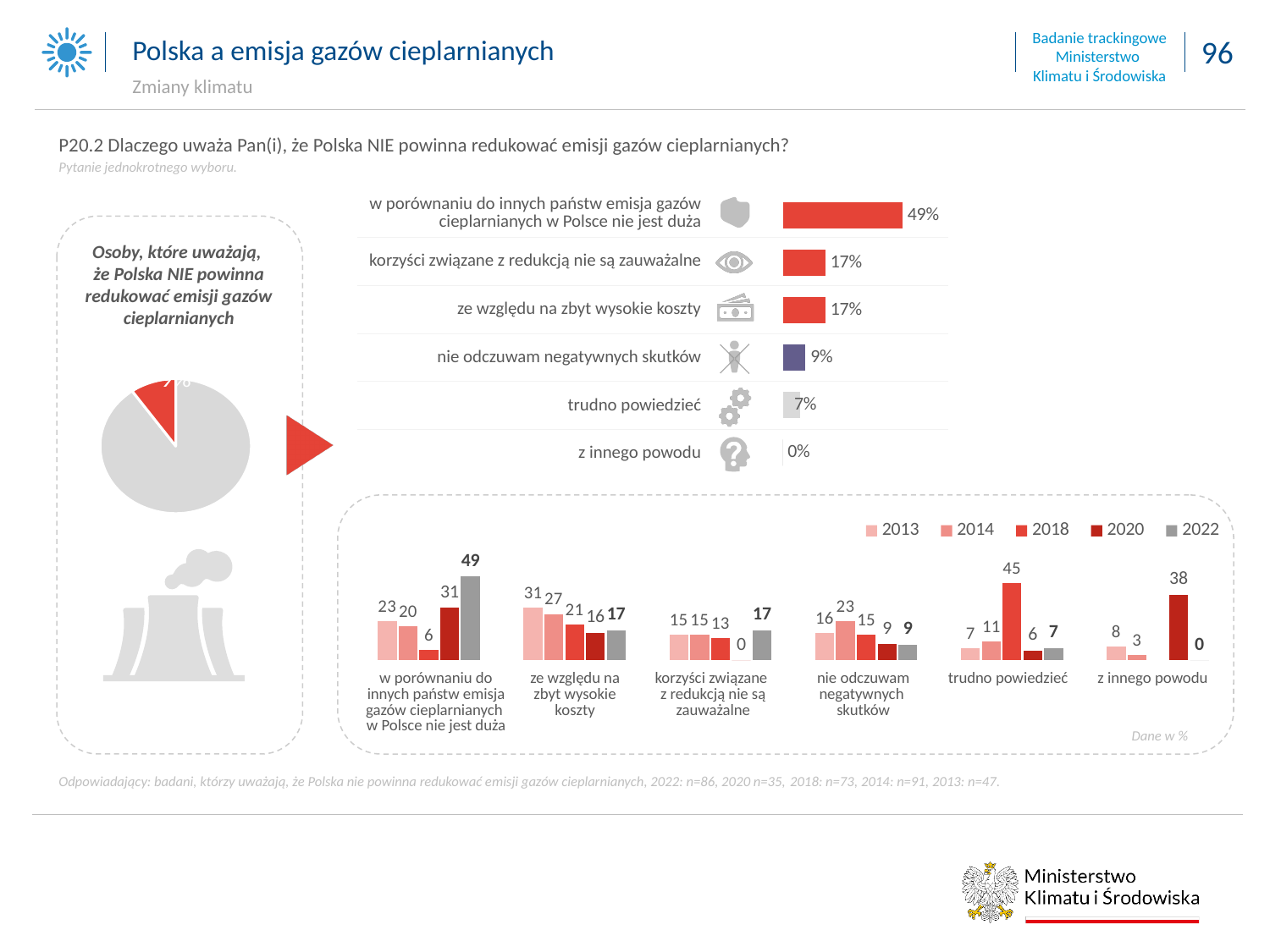
In the grouped bar chart at the bottom, what is the 2020 value for "z innego powodu"? 38 In the horizontal bar chart at the top right, which reason has the lowest percentage? z innego powodu In the horizontal bar chart at the top right, what percentage is shown for "nie odczuwam negatywnych skutków"? 9% In the horizontal bar chart at the top right, what percentage is shown for "w porównaniu do innych państw emisja gazów cieplarnianych w Polsce nie jest duża"? 49% In the grouped bar chart at the bottom, what is the 2018 value for "trudno powiedzieć"? 45 In the horizontal bar chart at the top right, what is the difference in percentage points between "w porównaniu do innych państw..." (49%) and "ze względu na zbyt wysokie koszty" (17%)? 32 In the grouped bar chart at the bottom, how many years does the legend list? 5 What type of chart is used at the top right of the slide to show the reasons with percentages? bar chart In the horizontal bar chart at the top right, which reason has the highest percentage? w porównaniu do innych państw emisja gazów cieplarnianych w Polsce nie jest duża In the grouped bar chart at the bottom, did the value for "w porównaniu do innych państw emisja gazów cieplarnianych w Polsce nie jest duża" rise or fall from 2020 to 2022? rise In the horizontal bar chart at the top right, how many reasons (categories) are listed? 6 In the grouped bar chart at the bottom, for "ze względu na zbyt wysokie koszty", which year has the larger value: 2013 or 2022? 2013